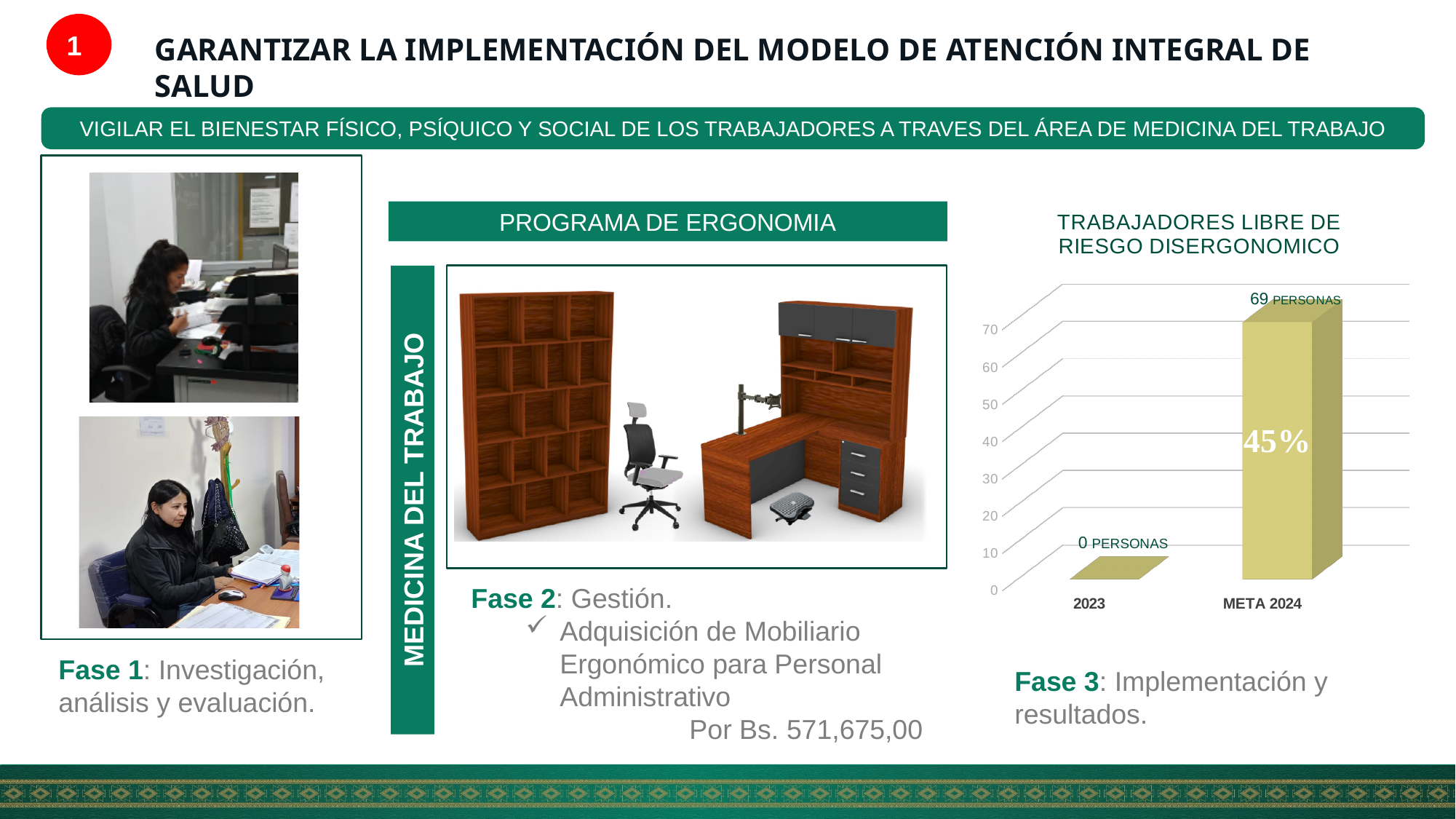
What is the title of the chart on the slide? TRABAJADORES LIBRE DE RIESGO DISERGONOMICO What percentage label is printed on the META 2024 bar? 45% What is the value shown for 2023 in the chart? 0 PERSONAS Which category has the highest value in the chart? META 2024 How many categories are shown on the x axis of the chart? 2 Which is larger in the chart, the value for 2023 or the value for META 2024? META 2024 What is the value shown for META 2024 in the chart? 69 PERSONAS Do the values rise or fall from 2023 to META 2024 in the chart? rise What type of chart is shown under the title TRABAJADORES LIBRE DE RIESGO DISERGONOMICO? bar chart Which category has the lowest value in the chart? 2023 What is the difference between the META 2024 value and the 2023 value in the chart? 69 Is the value for META 2024 greater or less than 60? greater